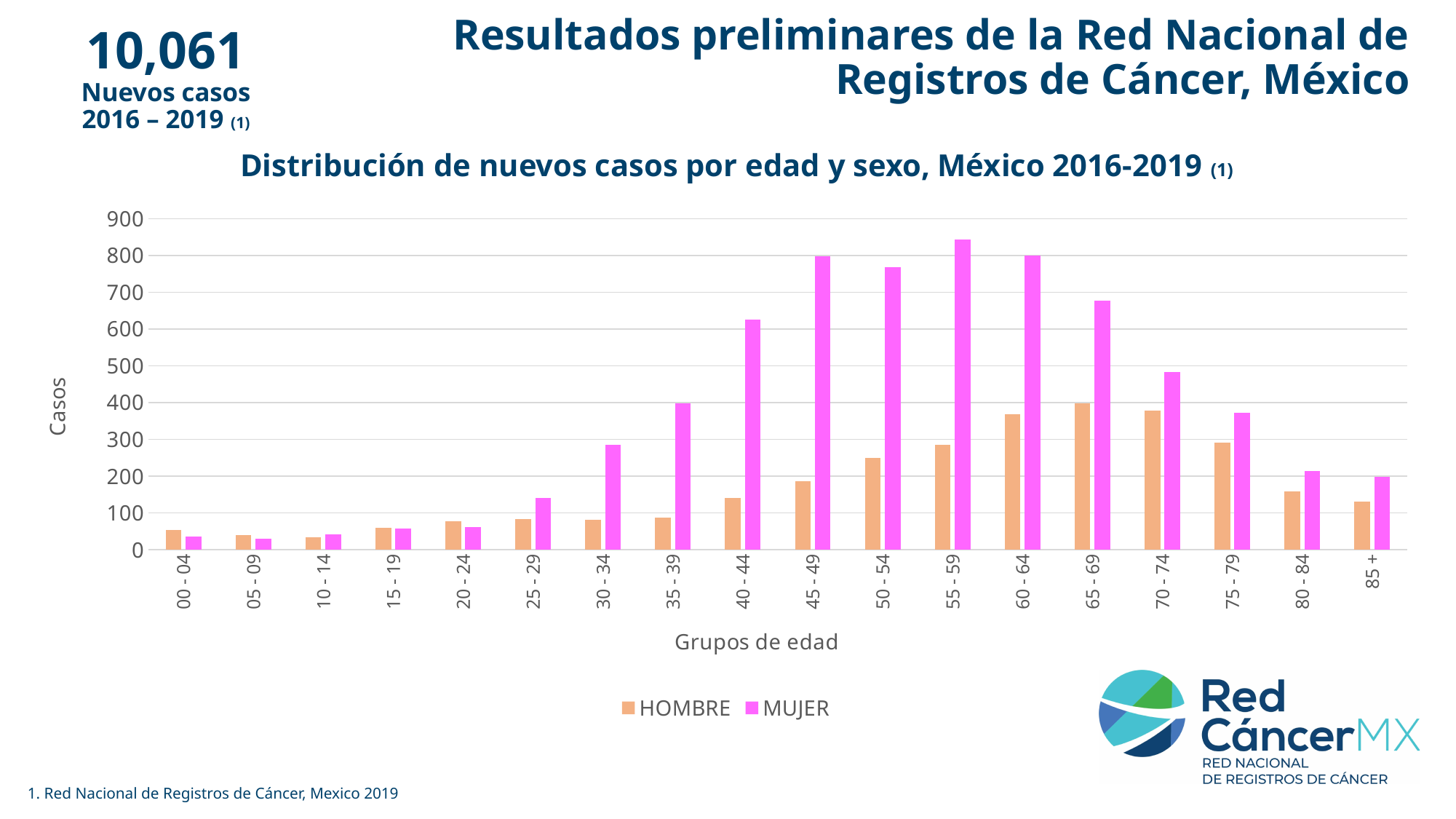
Is the MUJER value for 55 - 59 greater or less than 800? greater What is the label of the y axis? Casos How many age groups are shown on the x axis? 18 For the 45 - 49 age group, which series has the larger value, HOMBRE or MUJER? MUJER What kind of chart is shown on the slide? Bar chart For the 00 - 04 age group, which series has the larger value, HOMBRE or MUJER? HOMBRE Is the MUJER value for 70 - 74 greater or less than 500? less Is the MUJER value for 40 - 44 greater or less than 600? greater How many series does the legend list? 2 Which age group has the highest MUJER value? 55 - 59